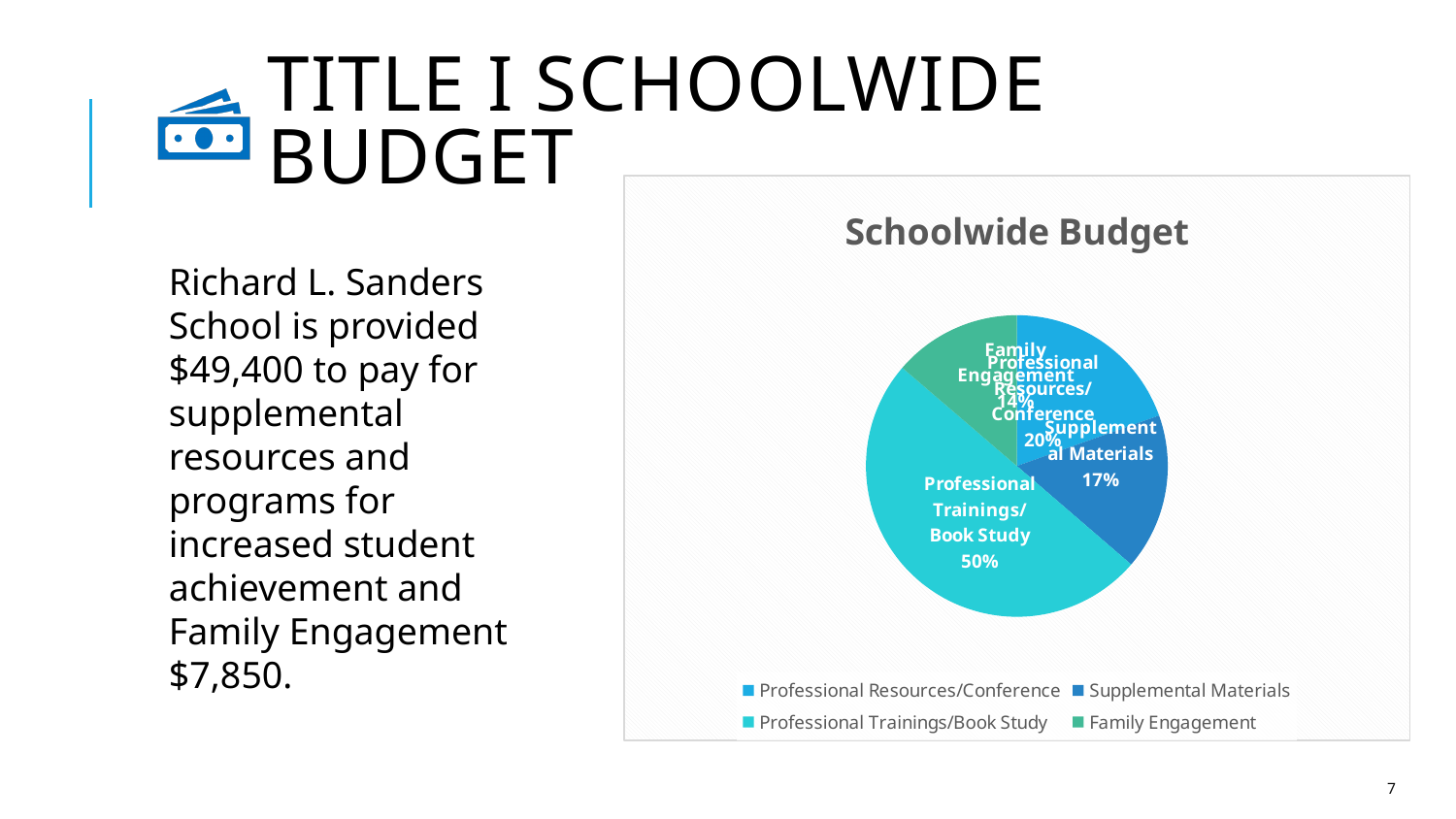
Which category has the smallest slice of the Schoolwide Budget pie? Family Engagement What share of the Schoolwide Budget pie is Family Engagement? 14% What share of the Schoolwide Budget pie is Professional Resources/Conference? 20% How many entries does the legend of the Schoolwide Budget chart list? 4 What is the title of the chart? Schoolwide Budget Which category has the largest slice of the Schoolwide Budget pie? Professional Trainings/Book Study Which is larger in the Schoolwide Budget pie: Professional Resources/Conference or Supplemental Materials? Professional Resources/Conference What kind of chart is shown on the slide? pie chart What share of the Schoolwide Budget pie is Supplemental Materials? 17% How many categories does the Schoolwide Budget pie chart show? 4 What is the difference in percentage points between Professional Trainings/Book Study and Family Engagement in the Schoolwide Budget pie? 36